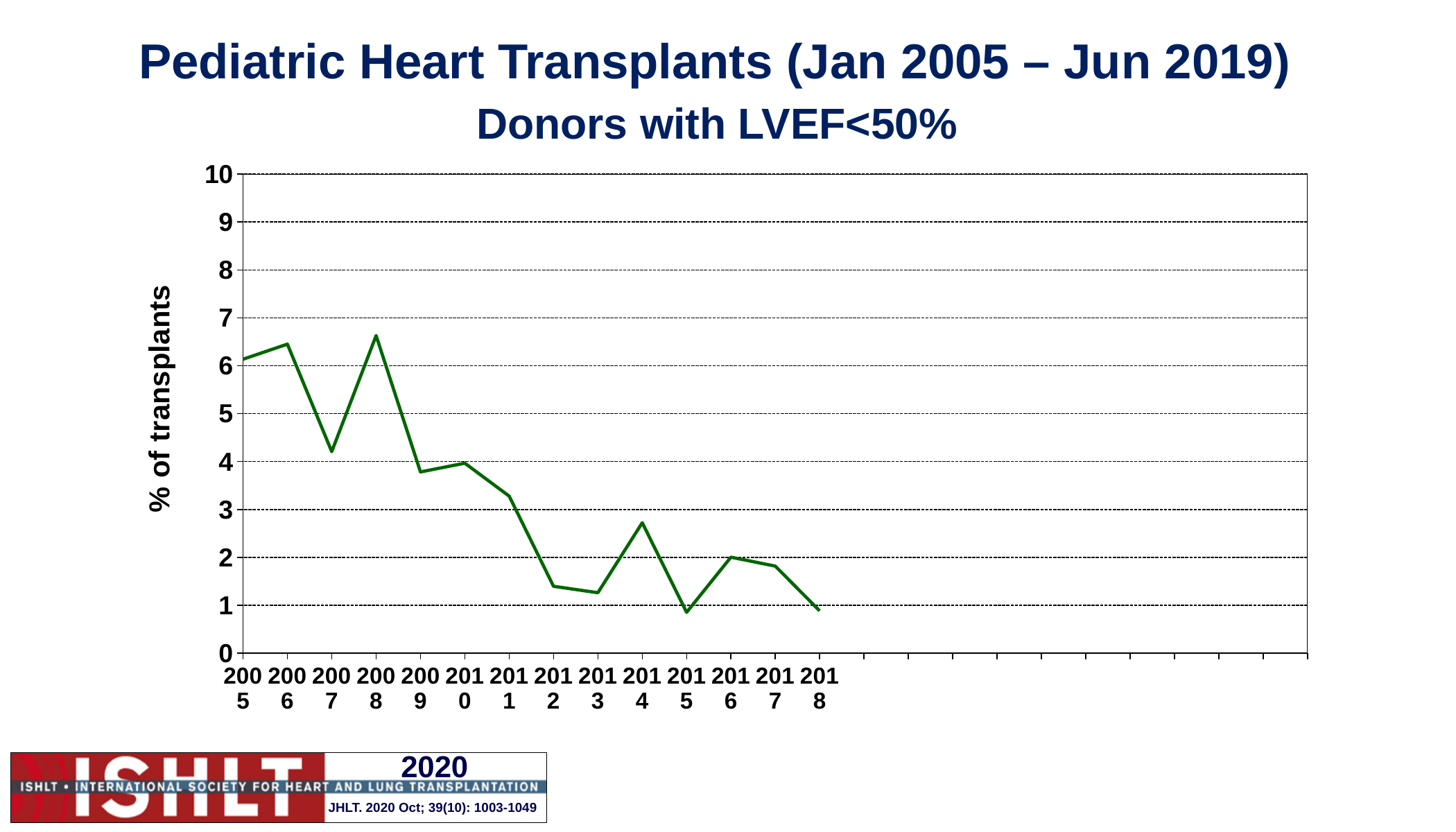
Which year has the larger value, 2007 or 2008? 2008 What kind of chart is shown on the slide? line chart Is the value for 2018 greater or less than 2? less Is the value for 2007 greater or less than 5? less Which year has the highest percentage of transplants from donors with LVEF<50%? 2008 How many years are plotted on the x axis? 14 Is the value for 2008 greater or less than 6? greater What is the label on the y axis? % of transplants Overall, do the values rise or fall from 2005 to 2018? fall Which year has the larger value, 2012 or 2014? 2014